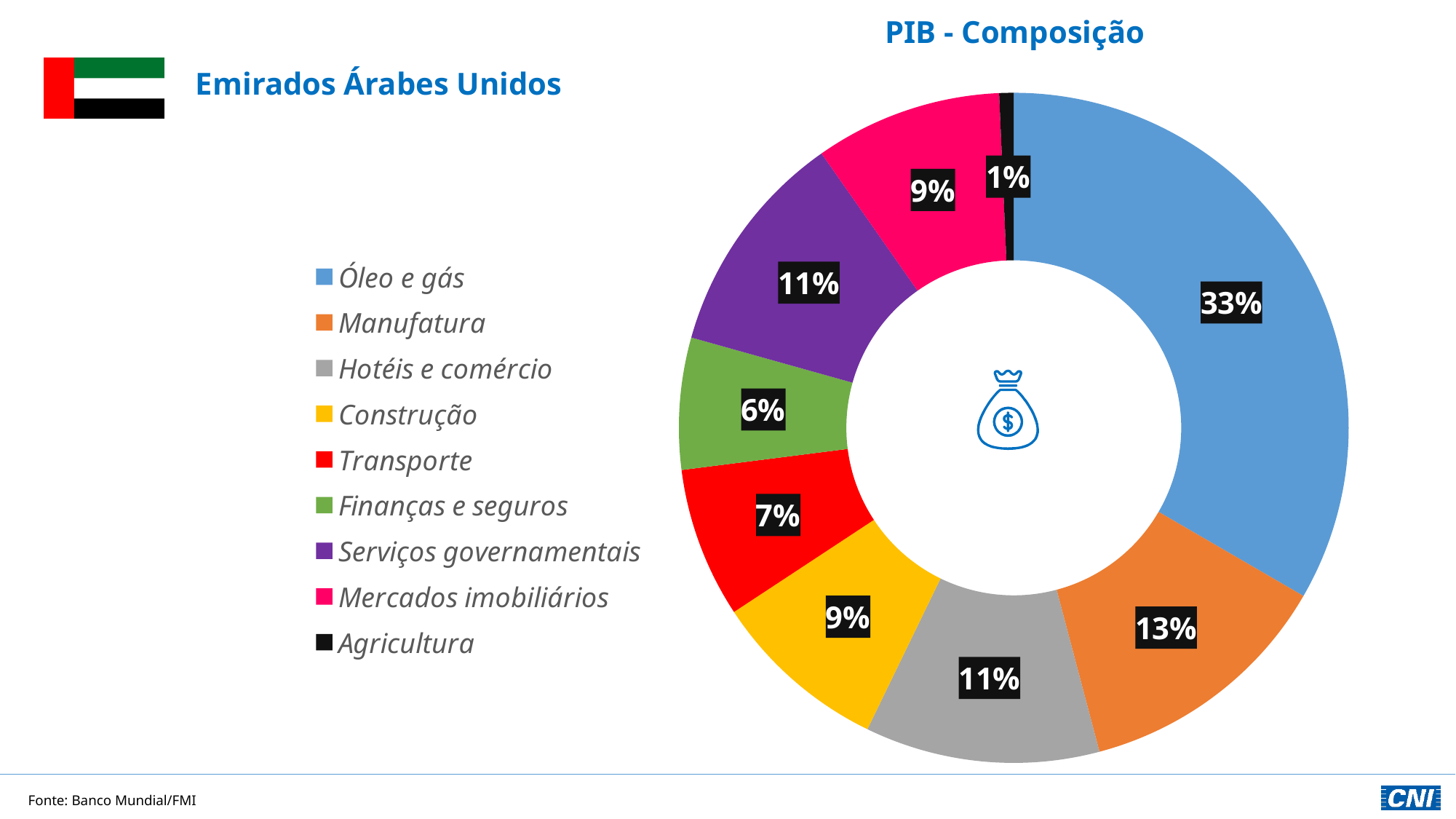
What is the difference between the shares of Óleo e gás and Manufatura? 20 percentage points What is the share of Manufatura in the PIB - Composição chart? 13% Which category has the largest share in the PIB - Composição chart? Óleo e gás Which has a larger share, Construção or Transporte? Construção What type of chart is shown on the slide? Pie chart (donut) Which category has the smallest share in the PIB - Composição chart? Agricultura What is the share of Finanças e seguros in the PIB - Composição chart? 6% How many categories does the legend of the PIB - Composição chart list? 9 What is the share of Agricultura in the PIB - Composição chart? 1% What is the share of Óleo e gás in the PIB - Composição chart? 33% What is the share of Transporte in the PIB - Composição chart? 7% What is the title of the chart on the slide? PIB - Composição